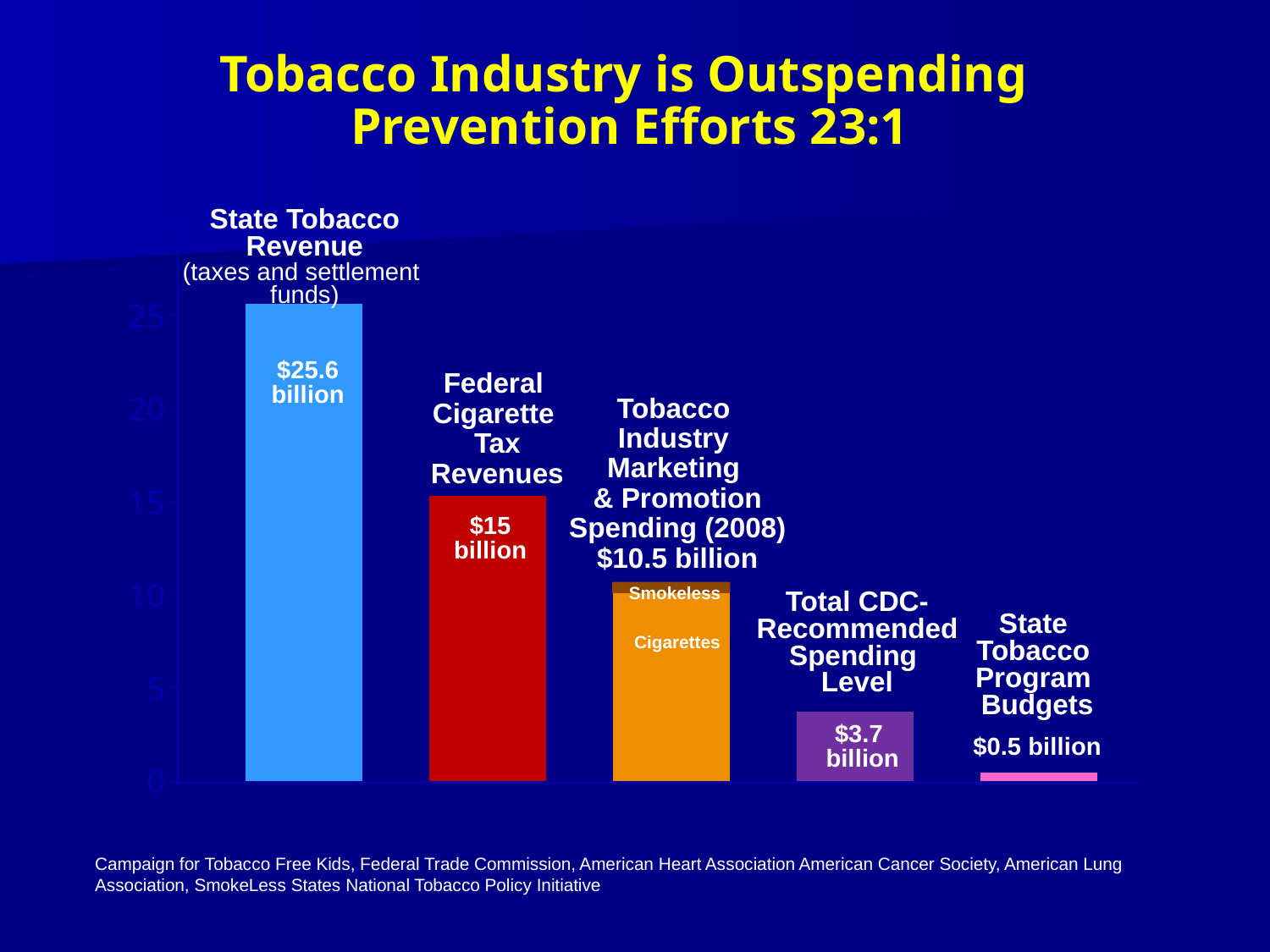
What is the value for Tobacco Industry Marketing & Promotion Spending (2008)? $10.5 billion What is the value for State Tobacco Revenue? $25.6 billion How many bars are shown in the chart? 5 What is the value for Federal Cigarette Tax Revenues? $15 billion What is the difference between the Total CDC-Recommended Spending Level and State Tobacco Program Budgets? $3.2 billion What is the value for State Tobacco Program Budgets? $0.5 billion What is the value for the Total CDC-Recommended Spending Level? $3.7 billion Which category has the lowest value? State Tobacco Program Budgets Which category has the highest value? State Tobacco Revenue Which is larger, Tobacco Industry Marketing & Promotion Spending (2008) or the Total CDC-Recommended Spending Level? Tobacco Industry Marketing & Promotion Spending (2008) What is the difference between State Tobacco Revenue and Federal Cigarette Tax Revenues? $10.6 billion What kind of chart is shown on the slide? Bar chart